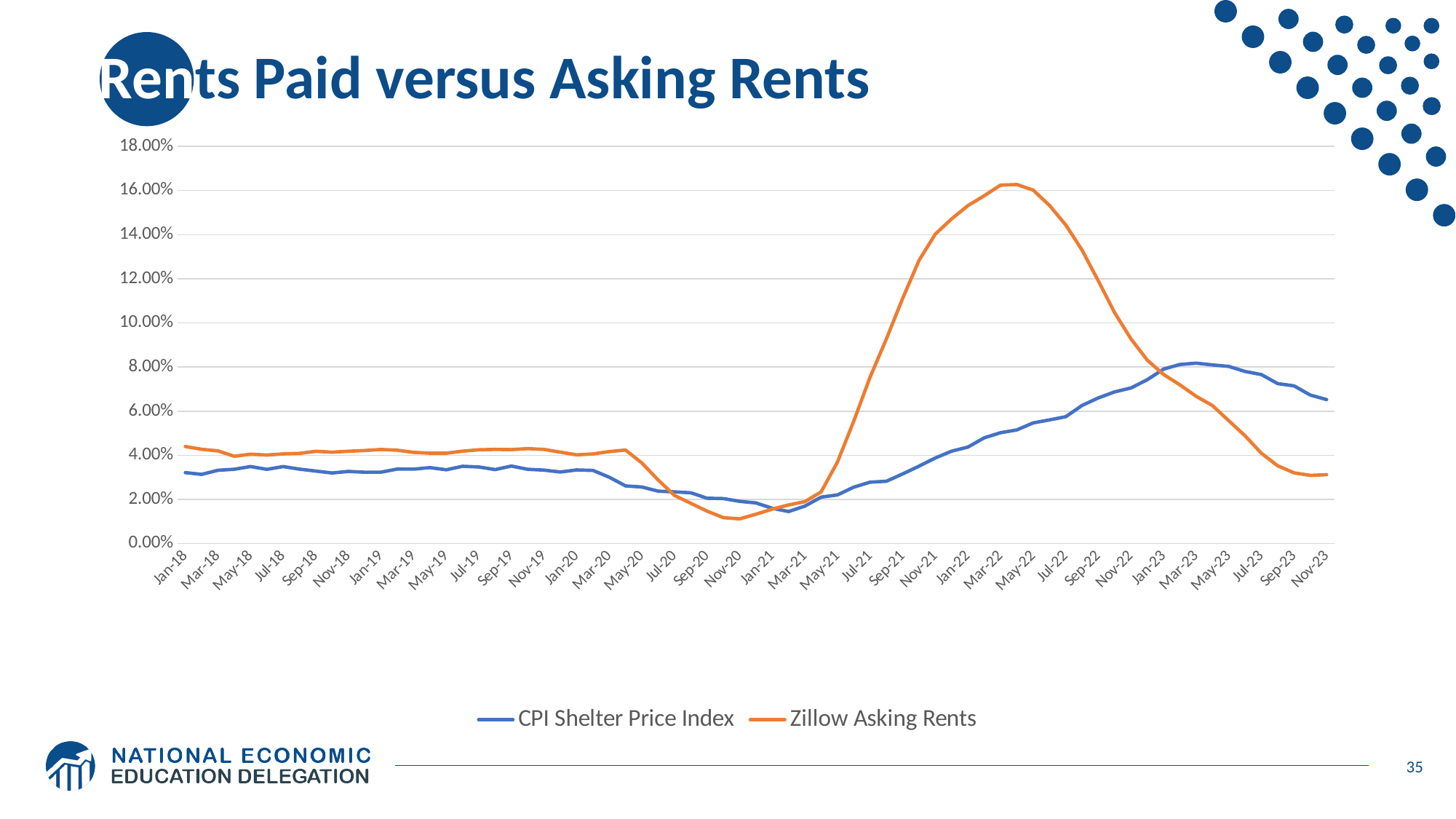
Is the peak value of Zillow Asking Rents greater or less than 16.00%? greater Does the Zillow Asking Rents series rise or fall between Mar-22 and Nov-23? fall In Mar-22, which series has the larger value, CPI Shelter Price Index or Zillow Asking Rents? Zillow Asking Rents Is the peak value of the CPI Shelter Price Index greater or less than 10.00%? less Is the value of Zillow Asking Rents in Nov-20 greater or less than 2.00%? less In Nov-23, which series has the larger value, CPI Shelter Price Index or Zillow Asking Rents? CPI Shelter Price Index What kind of chart is shown on the slide? line chart Which series reaches the higher peak value over the period shown? Zillow Asking Rents How many series does the legend list? 2 What is the title of the chart on the slide? Rents Paid versus Asking Rents Which series is drawn in orange? Zillow Asking Rents